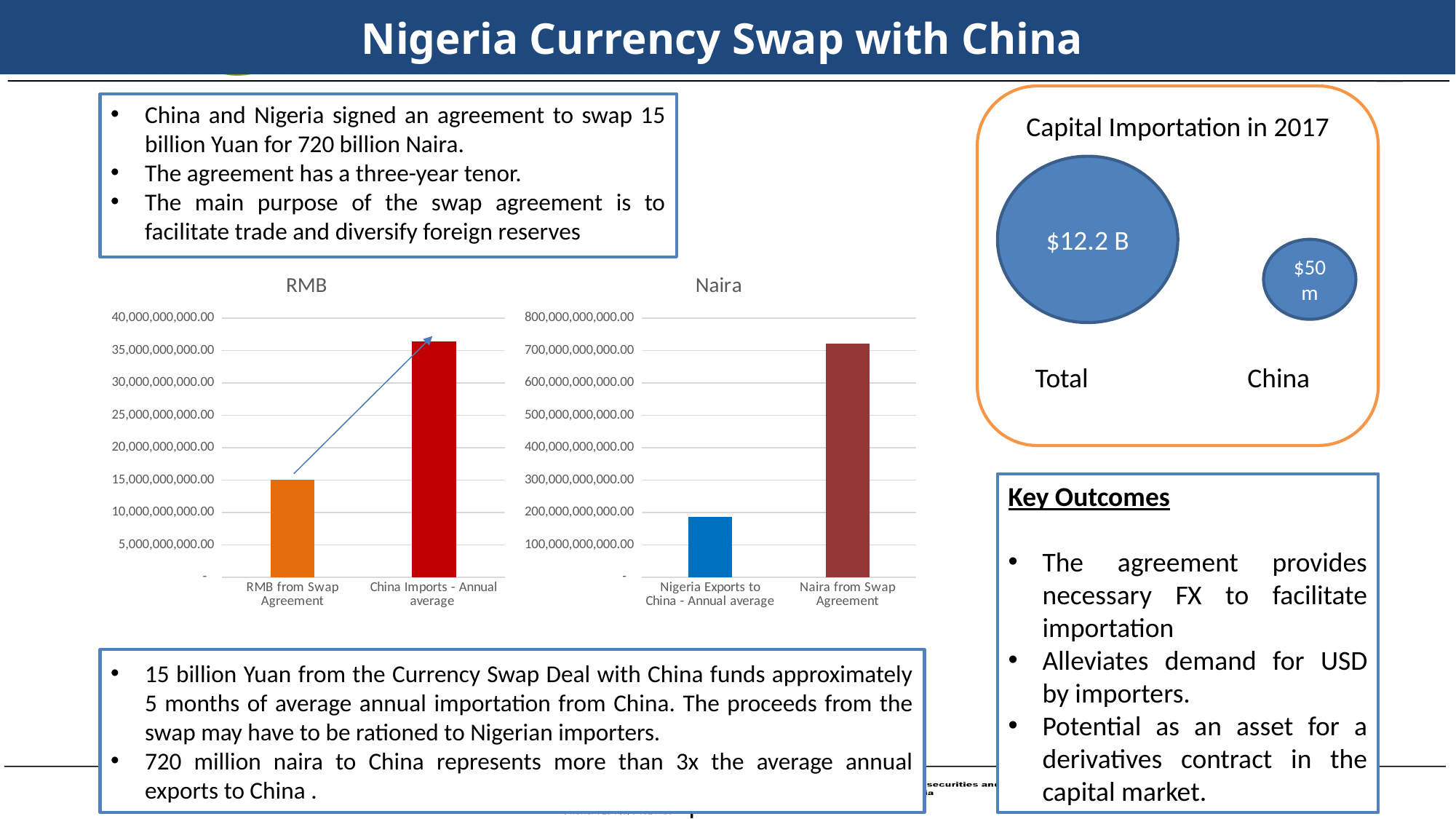
In the RMB chart, which is larger: RMB from Swap Agreement or China Imports - Annual average? China Imports - Annual average In the RMB chart, which category has the highest value? China Imports - Annual average In the RMB chart, what is the value for RMB from Swap Agreement? 15,000,000,000.00 What kind of chart is the Naira chart? bar chart What is the title of the chart on the left? RMB What kind of chart is the RMB chart? bar chart How many categories does the Naira chart show? 2 How many categories does the RMB chart show? 2 In the RMB chart, is the value for China Imports - Annual average greater or less than 35,000,000,000.00? greater In the Naira chart, which category has the lowest value? Nigeria Exports to China - Annual average In the Naira chart, is the value for Naira from Swap Agreement greater or less than 700,000,000,000.00? greater In the Naira chart, is the value for Nigeria Exports to China - Annual average greater or less than 200,000,000,000.00? less